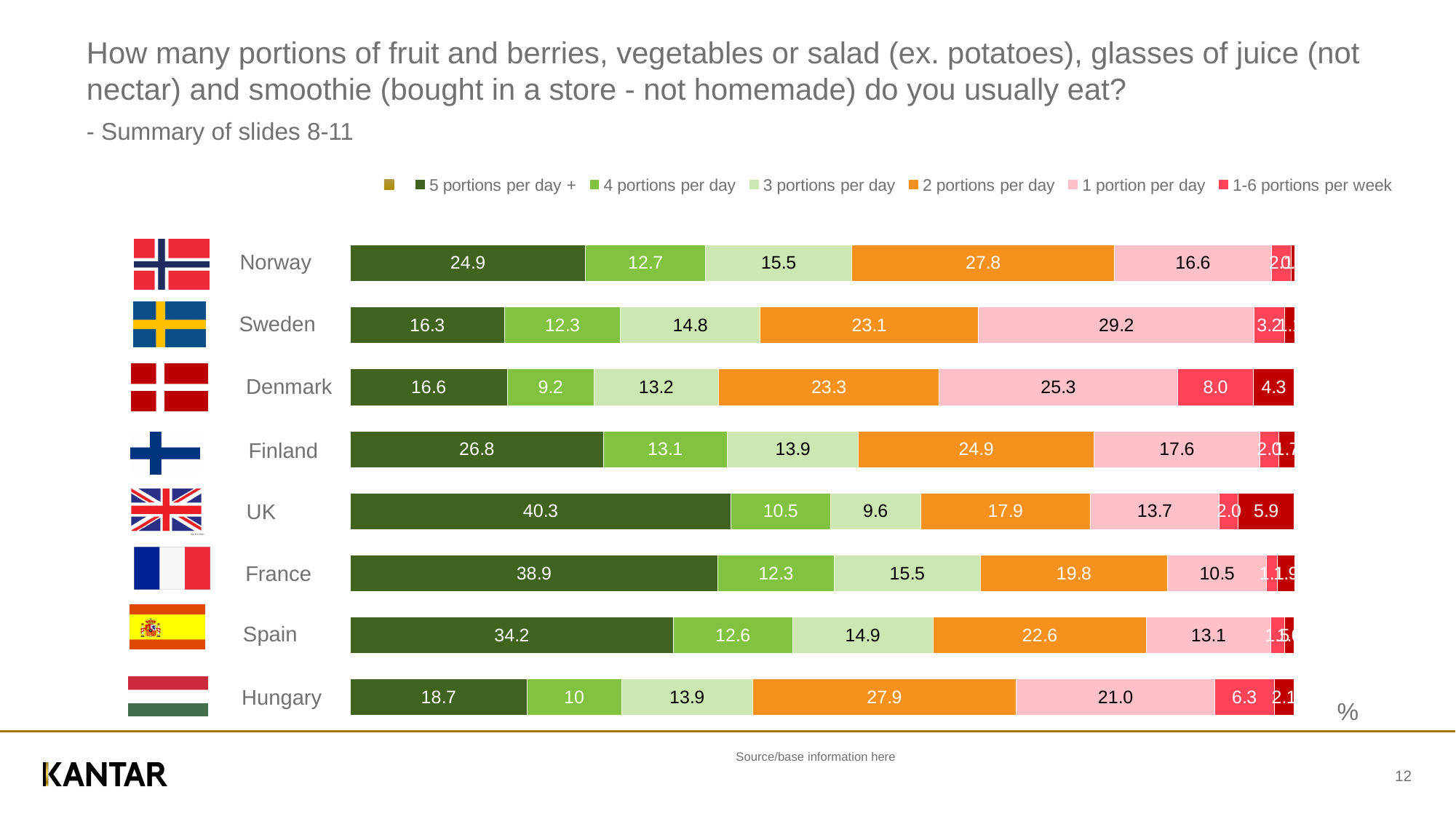
Which country's bar is listed first (at the top) of the chart? Norway What type of chart is shown on the slide? Stacked bar chart Which is larger: the "4 portions per day" value for Denmark or for Spain? Spain Which is larger: the "2 portions per day" value for Norway or for Finland? Norway What is the value for "5 portions per day +" for the UK? 40.3 What is the value for "1-6 portions per week" for Denmark? 8.0 How many countries are shown in the chart? 8 Which country has the highest value for "5 portions per day +"? UK Which country has the lowest value for "5 portions per day +"? Sweden What is the value for "1 portion per day" for Sweden? 29.2 What is the value for "2 portions per day" for Hungary? 27.9 What is the difference between the "5 portions per day +" values for the UK and France? 1.4